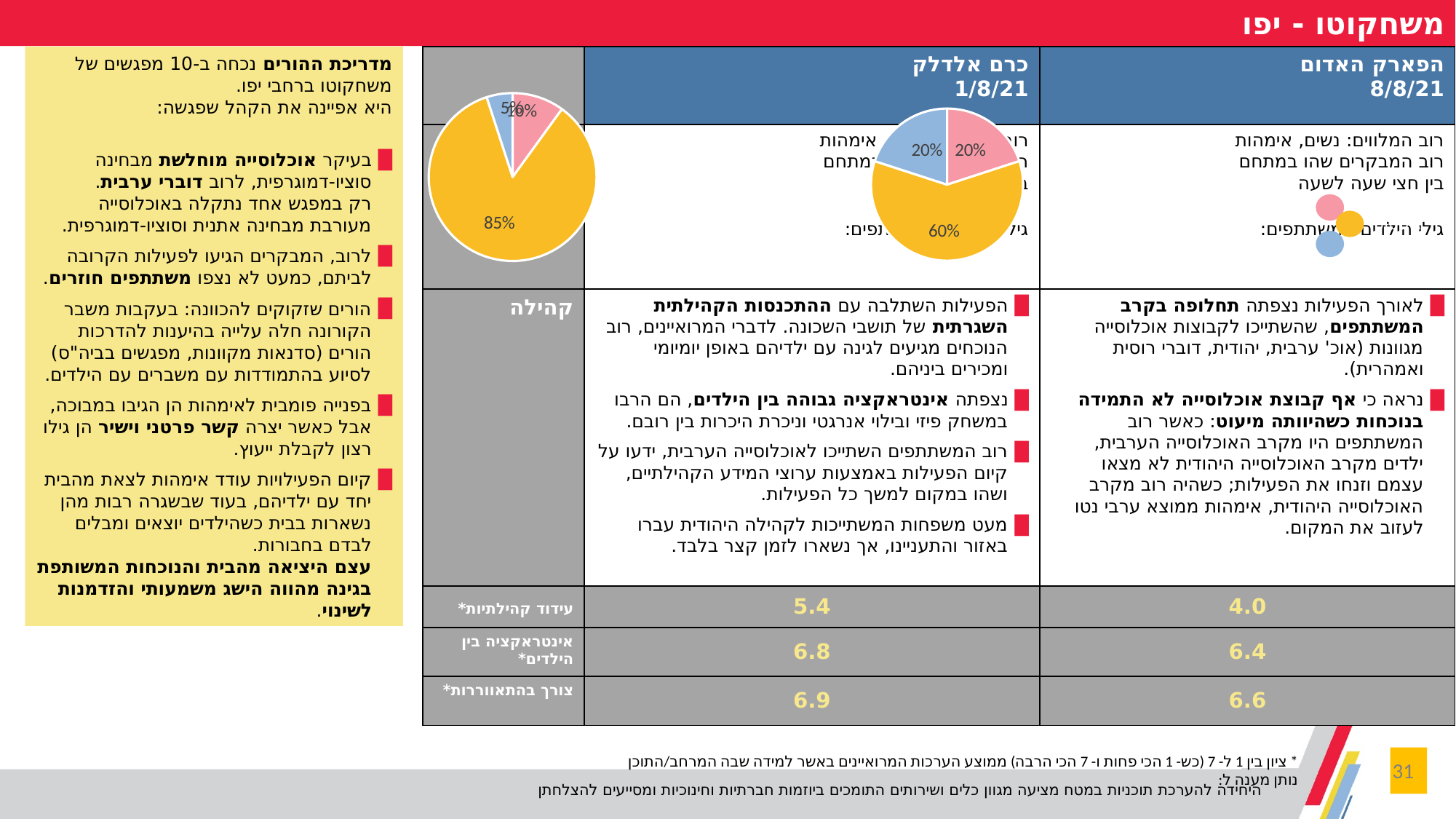
In the pie chart on the left (grey column), what is the share of the smallest slice? 5% In the pie chart on the left (grey column), what is the difference between the largest slice and the pink slice? 75% What kind of chart is shown on the left side of the table, in the grey column? Pie chart In the pie chart on the left (grey column), what is the share of the largest slice? 85% In the pie chart on the left (grey column), what percentage is shown for the pink slice? 10% How many slices does the pie chart under the heading 'כרם אלדלק 1/8/21' have? 3 In the pie chart under 'כרם אלדלק 1/8/21', what is the difference between the yellow slice and the pink slice? 40% How many slices does the pie chart on the left (grey column) have? 3 In the pie chart under 'כרם אלדלק 1/8/21', what is the share of the yellow slice? 60% In the pie chart under 'כרם אלדלק 1/8/21', which colour slice is the largest? Yellow Which is larger: the yellow slice in the pie chart on the left (grey column) or the yellow slice in the pie chart under 'כרם אלדלק 1/8/21'? The yellow slice in the pie chart on the left (85%) In the pie chart under 'כרם אלדלק 1/8/21', what percentage is shown for the blue slice? 20%